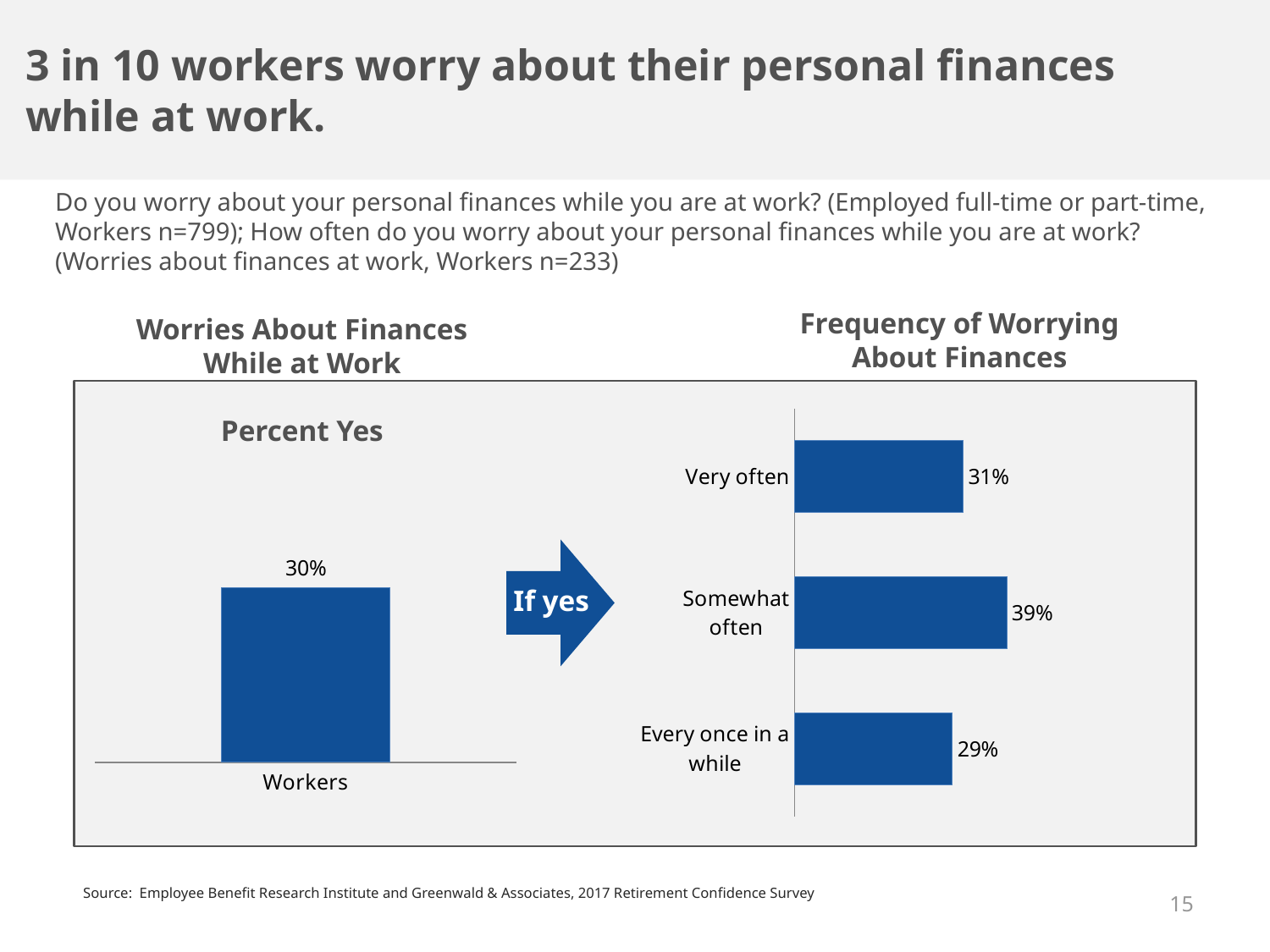
In the 'Frequency of Worrying About Finances' chart, what is the value for Every once in a while? 29% In the 'Frequency of Worrying About Finances' chart, which category has the highest value? Somewhat often How many categories are shown in the 'Frequency of Worrying About Finances' chart? 3 In the 'Frequency of Worrying About Finances' chart, what is the value for Very often? 31% In the 'Frequency of Worrying About Finances' chart, what is the value for Somewhat often? 39% In the 'Frequency of Worrying About Finances' chart, what is the difference between Somewhat often and Very often? 8% In the 'Worries About Finances While at Work' chart, what is the value for Workers? 30% In the 'Frequency of Worrying About Finances' chart, what is the difference between Somewhat often and Every once in a while? 10% In the 'Frequency of Worrying About Finances' chart, which is larger, Very often or Every once in a while? Very often What kind of chart is the 'Frequency of Worrying About Finances' chart? Bar chart In the 'Frequency of Worrying About Finances' chart, which category has the lowest value? Every once in a while